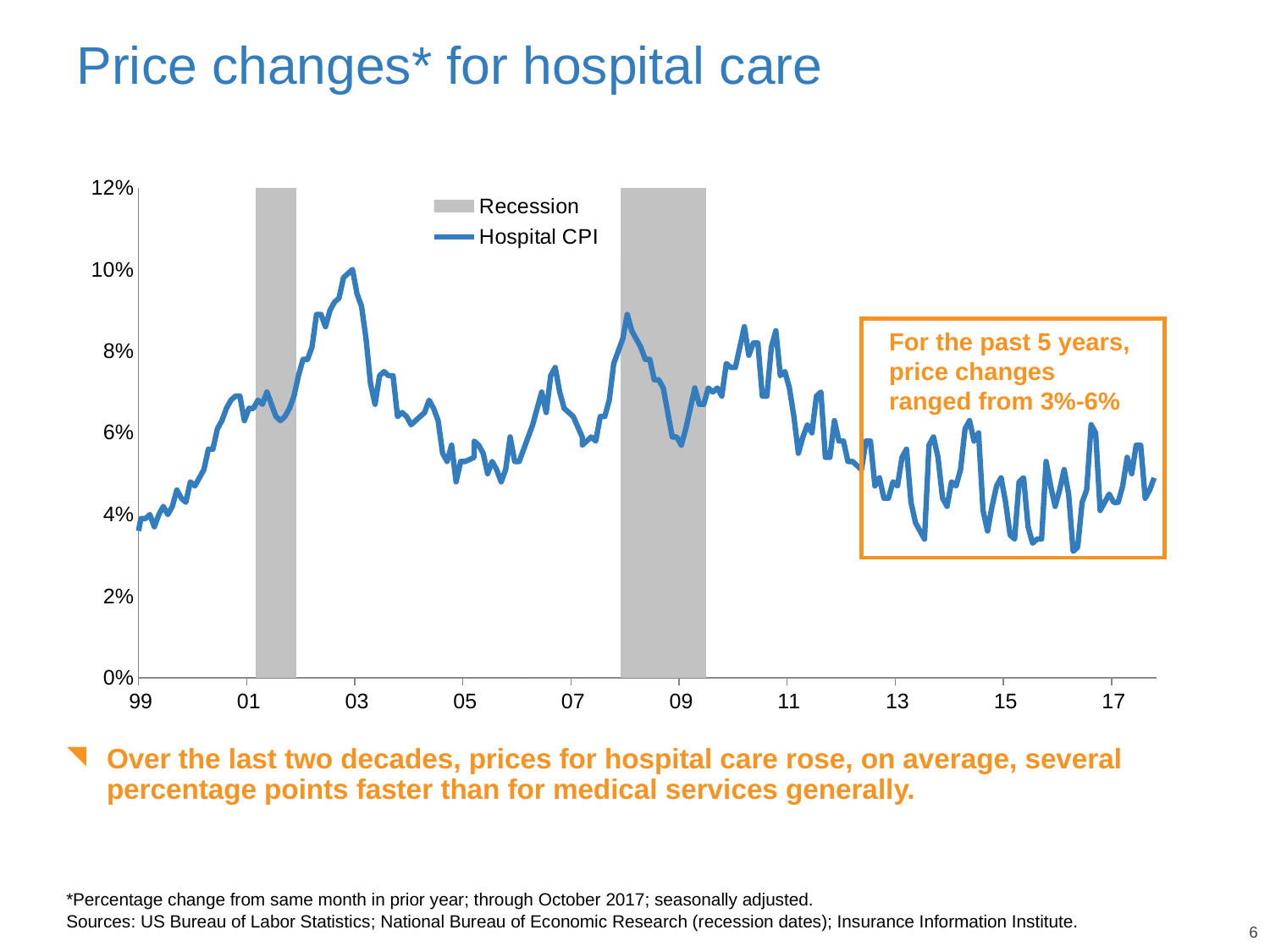
Is the Hospital CPI peak during the 2008-2009 recession greater or less than 8%? greater Is the peak value of Hospital CPI around 2003 greater or less than 8%? greater Does the Hospital CPI line generally rise or fall from 2011 to 2017? fall What kind of chart is shown on the slide? Line chart Does the Hospital CPI line generally rise or fall from 1999 to 2003? rise Is the lowest Hospital CPI value around 2016 greater or less than 4%? less Around which year does the Hospital CPI line reach its highest point? 03 According to the annotation box on the chart, what range did price changes fall within over the past 5 years? 3%-6% What does the grey shading on the chart represent, according to the legend? Recession How many entries does the chart legend list? 2 What is the title of the slide's chart? Price changes* for hospital care